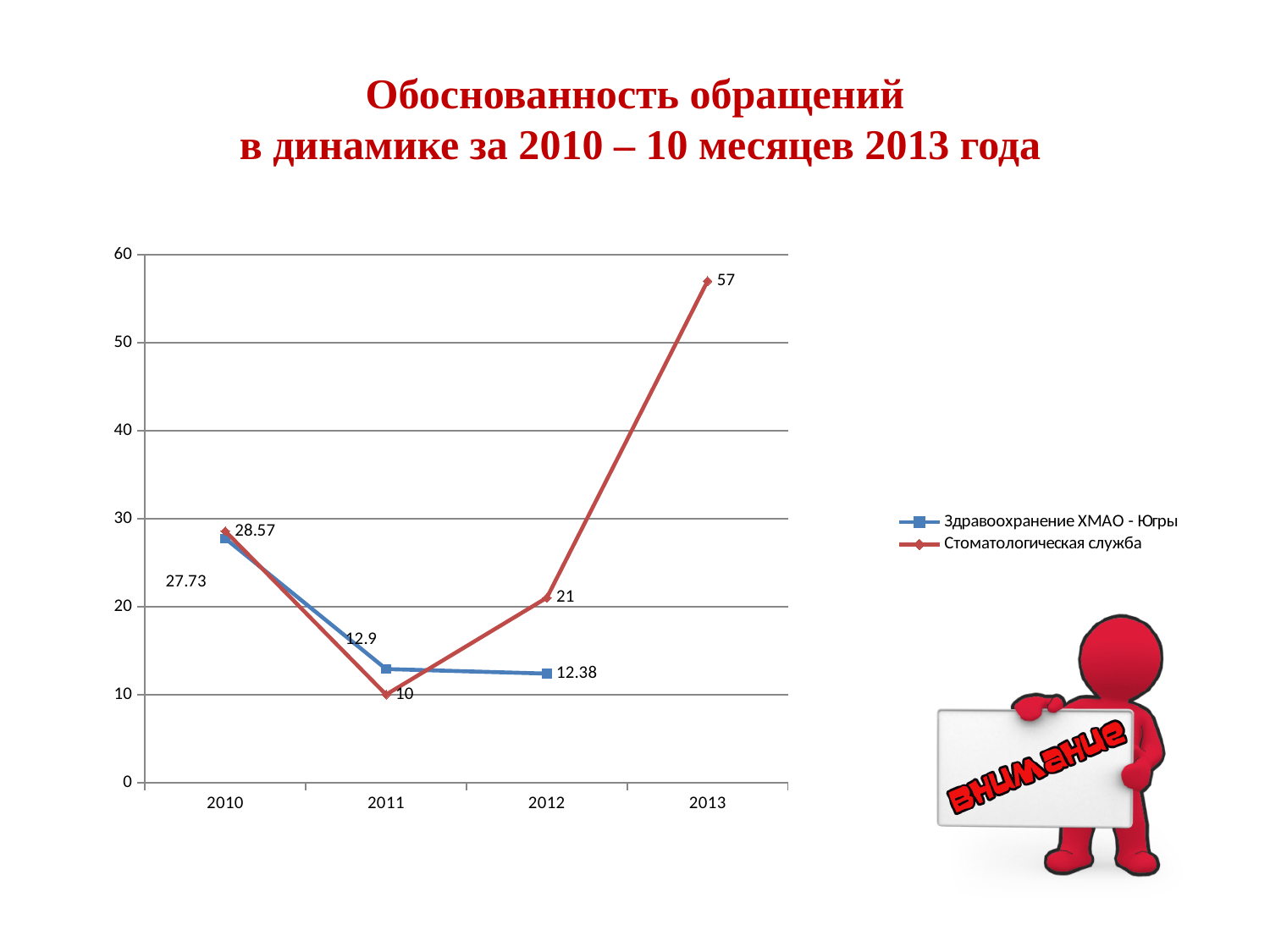
What is the value for Стоматологическая служба in 2011? 10 Does the Стоматологическая служба line rise or fall from 2011 to 2013? rise Which series has the larger value in 2012, Здравоохранение ХМАО - Югры or Стоматологическая служба? Стоматологическая служба What is the value for Здравоохранение ХМАО - Югры in 2010? 27.73 What is the value for Стоматологическая служба in 2013? 57 How many series does the legend list? 2 In which year does Стоматологическая служба reach its highest value? 2013 How many years are shown on the x axis? 4 What is the value for Здравоохранение ХМАО - Югры in 2012? 12.38 What is the difference between the Стоматологическая служба values in 2013 and 2012? 36 In which year does Стоматологическая служба have its lowest value? 2011 What type of chart is shown on the slide? line chart